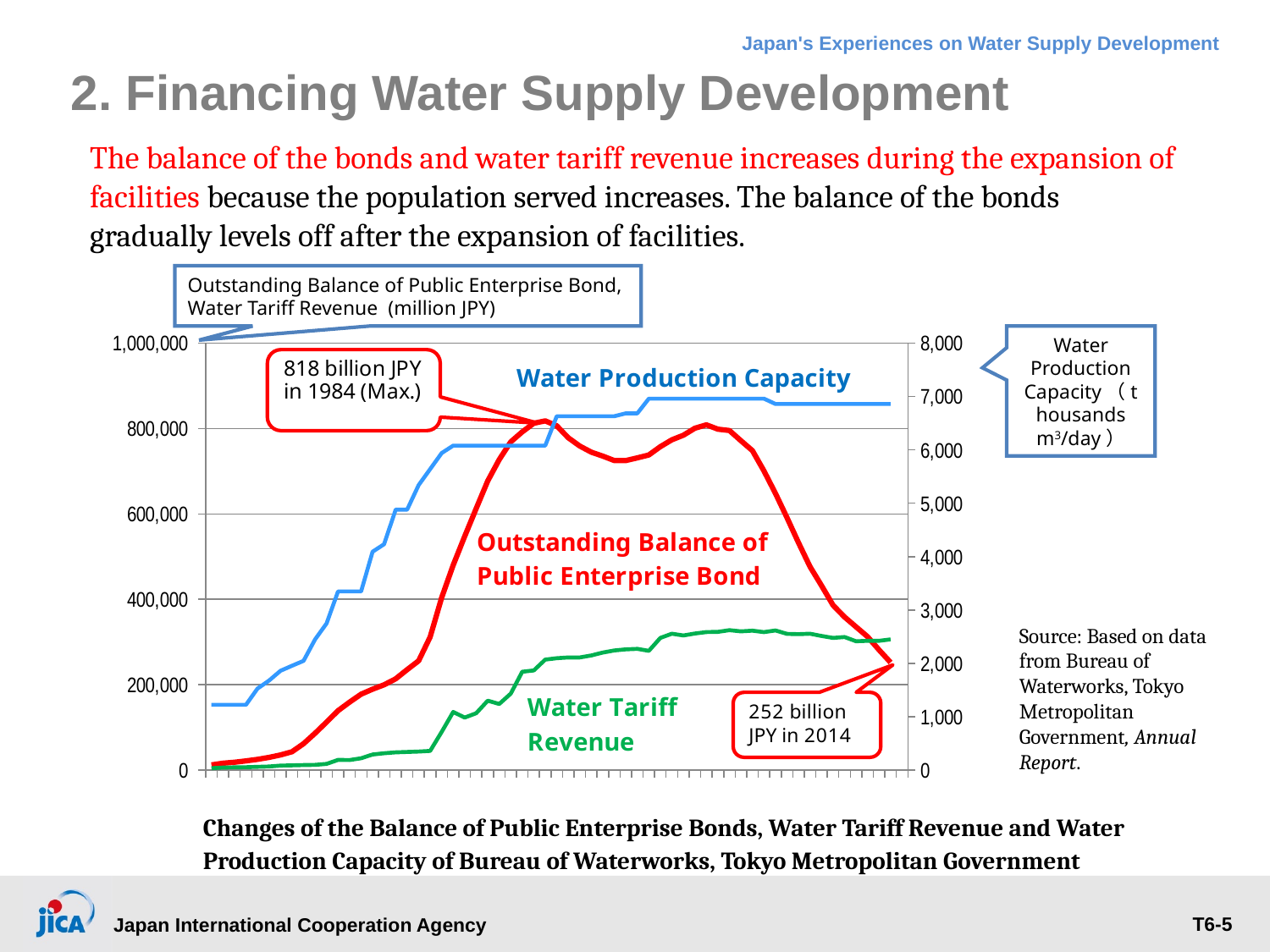
At the right end of the chart, is the Water Production Capacity greater or less than 6,000 on the right axis? greater What was the Outstanding Balance of Public Enterprise Bond in 2014, according to the callout? 252 billion JPY Which series reaches the highest value on the left axis? Outstanding Balance of Public Enterprise Bond Does the Water Production Capacity generally rise or fall from the left to the right of the chart? rise By how much did the Outstanding Balance of Public Enterprise Bond fall from its 1984 maximum to 2014? 566 billion JPY What unit is given for the left axis (Outstanding Balance of Public Enterprise Bond and Water Tariff Revenue)? million JPY What kind of chart is shown on the slide? line chart In which year did the Outstanding Balance of Public Enterprise Bond reach its maximum? 1984 How many data series are plotted on the chart? 3 At the right end of the chart, is the Water Tariff Revenue greater or less than 400,000 on the left axis? less Which series has the higher peak value: Outstanding Balance of Public Enterprise Bond or Water Tariff Revenue? Outstanding Balance of Public Enterprise Bond What was the maximum value of the Outstanding Balance of Public Enterprise Bond, according to the callout? 818 billion JPY